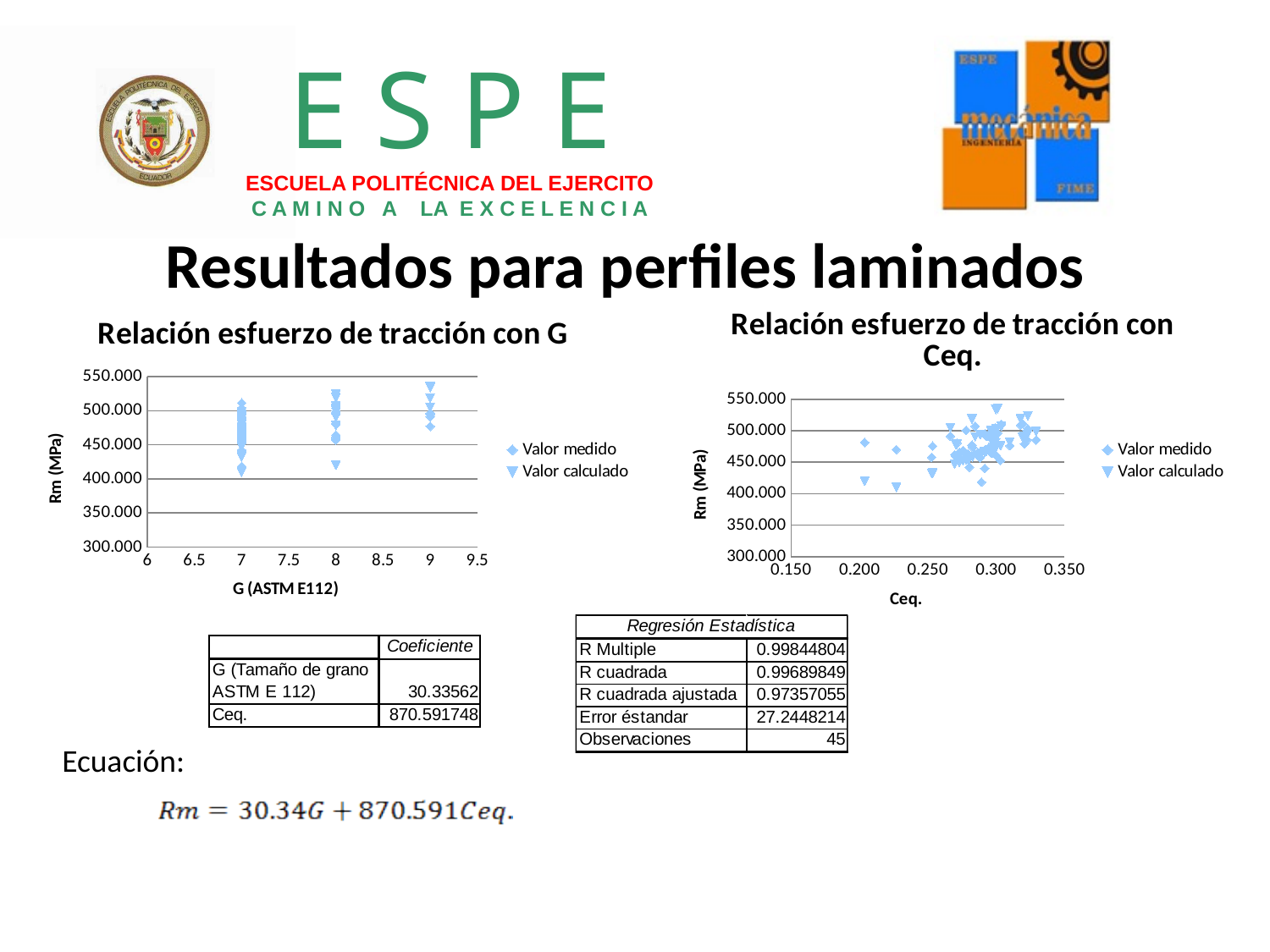
In the chart 'Relación esfuerzo de tracción con Ceq.', are all plotted values greater or less than 550.000? less What kind of chart is the chart titled 'Relación esfuerzo de tracción con G'? scatter chart In the chart 'Relación esfuerzo de tracción con G', what are the two series named in the legend? Valor medido and Valor calculado How many series does the legend of the chart 'Relación esfuerzo de tracción con Ceq.' list? 2 What kind of chart is the chart titled 'Relación esfuerzo de tracción con Ceq.'? scatter chart In the chart 'Relación esfuerzo de tracción con G', are the values plotted at G = 8 greater or less than 400.000? greater In the chart 'Relación esfuerzo de tracción con Ceq.', are the plotted values greater or less than 350.000? greater What is the x-axis title of the chart 'Relación esfuerzo de tracción con G'? G (ASTM E112) In the chart 'Relación esfuerzo de tracción con Ceq.', do the plotted Rm values generally rise or fall as Ceq. increases? rise In the chart 'Relación esfuerzo de tracción con G', at how many distinct G values are data points plotted? 3 How many series does the legend of the chart 'Relación esfuerzo de tracción con G' list? 2